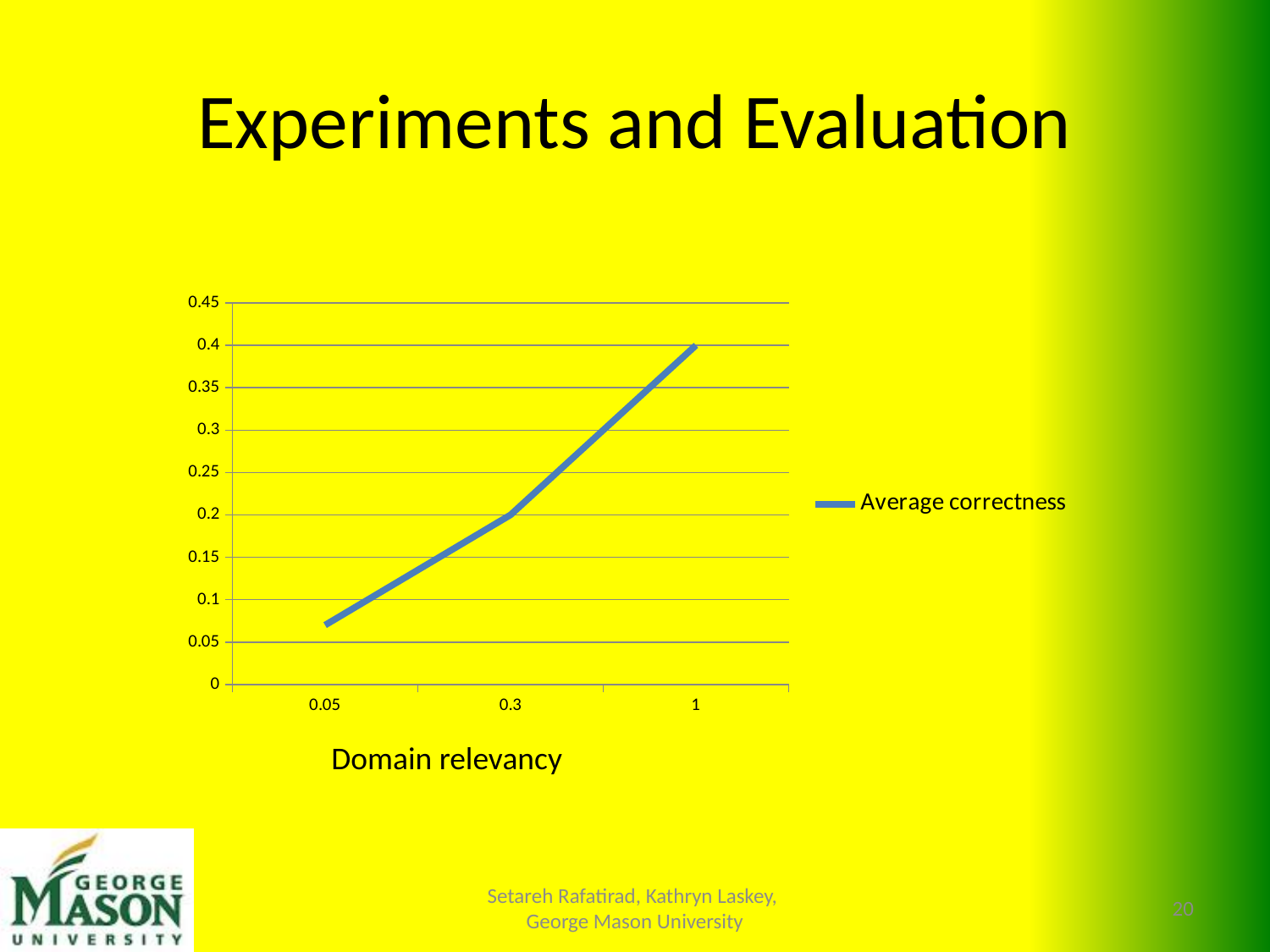
How many series does the legend list? 1 Does the average correctness rise or fall as domain relevancy increases along the x axis? rise What kind of chart is shown on the slide? line chart How many data points are plotted on the line? 3 Is the average correctness at domain relevancy 0.05 greater or less than 0.05? greater At which domain relevancy value is the average correctness lowest? 0.05 What is the average correctness at domain relevancy 0.3? 0.2 At which domain relevancy value is the average correctness highest? 1 What is the average correctness at domain relevancy 1? 0.4 Is the average correctness at domain relevancy 0.05 greater or less than 0.1? less What is the name of the series shown in the legend? Average correctness What is the label of the x axis? Domain relevancy